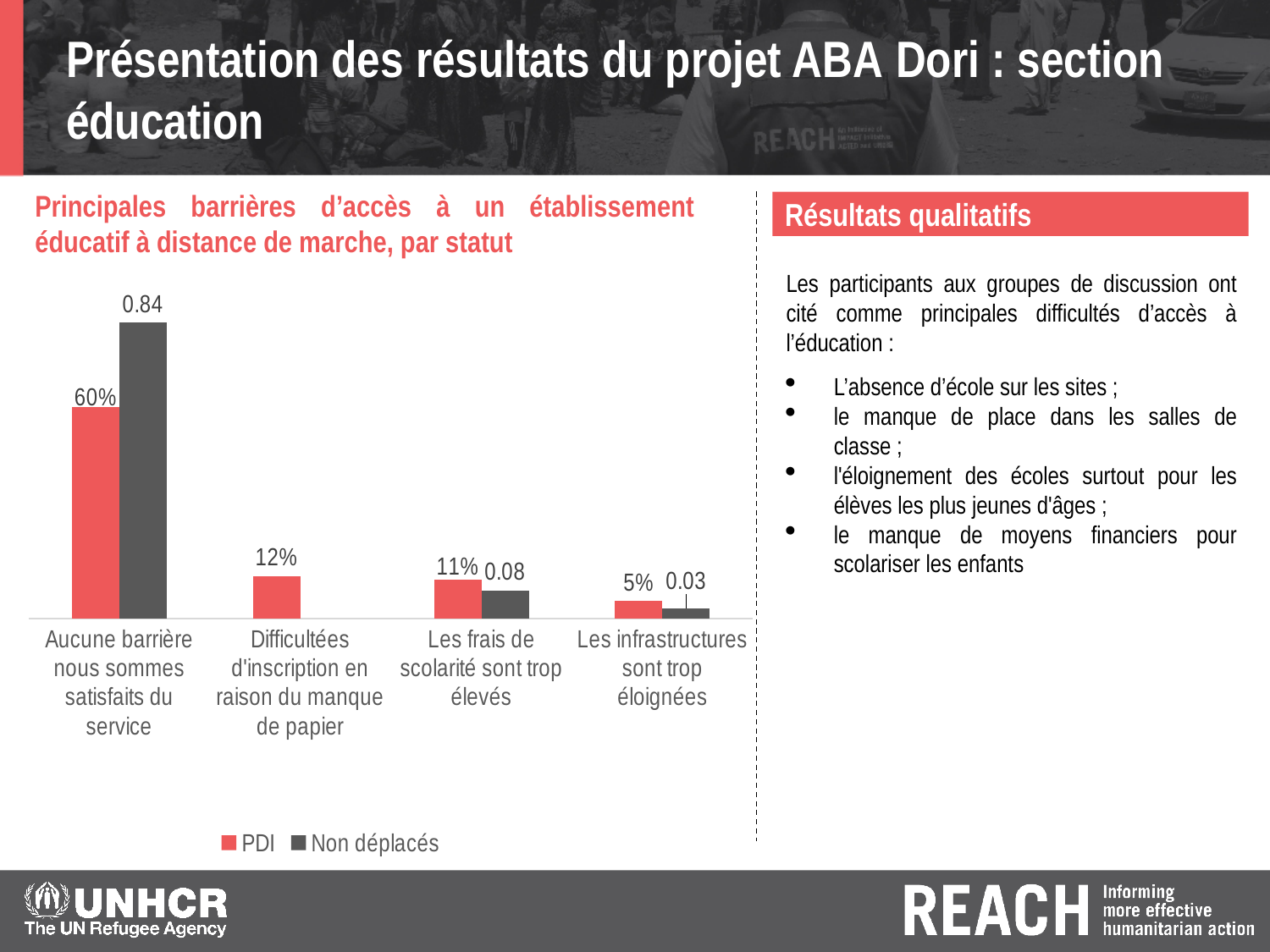
How many series does the chart legend list? 2 What is the value for PDI in the category "Les infrastructures sont trop éloignées"? 5% In the category "Aucune barrière nous sommes satisfaits du service", which series has the larger value, PDI or Non déplacés? Non déplacés Which category has the highest value for the PDI series? Aucune barrière nous sommes satisfaits du service What type of chart is shown on the slide? Bar chart What is the value for Non déplacés in the category "Les frais de scolarité sont trop élevés"? 0.08 How many categories are shown on the x axis of the chart? 4 What is the value for Non déplacés in the category "Aucune barrière nous sommes satisfaits du service"? 0.84 What is the value for PDI in the category "Aucune barrière nous sommes satisfaits du service"? 60% What is the difference between the PDI values for "Aucune barrière nous sommes satisfaits du service" and "Difficultées d'inscription en raison du manque de papier"? 48% What is the value for PDI in the category "Difficultées d'inscription en raison du manque de papier"? 12% Which category has the lowest value for the PDI series? Les infrastructures sont trop éloignées